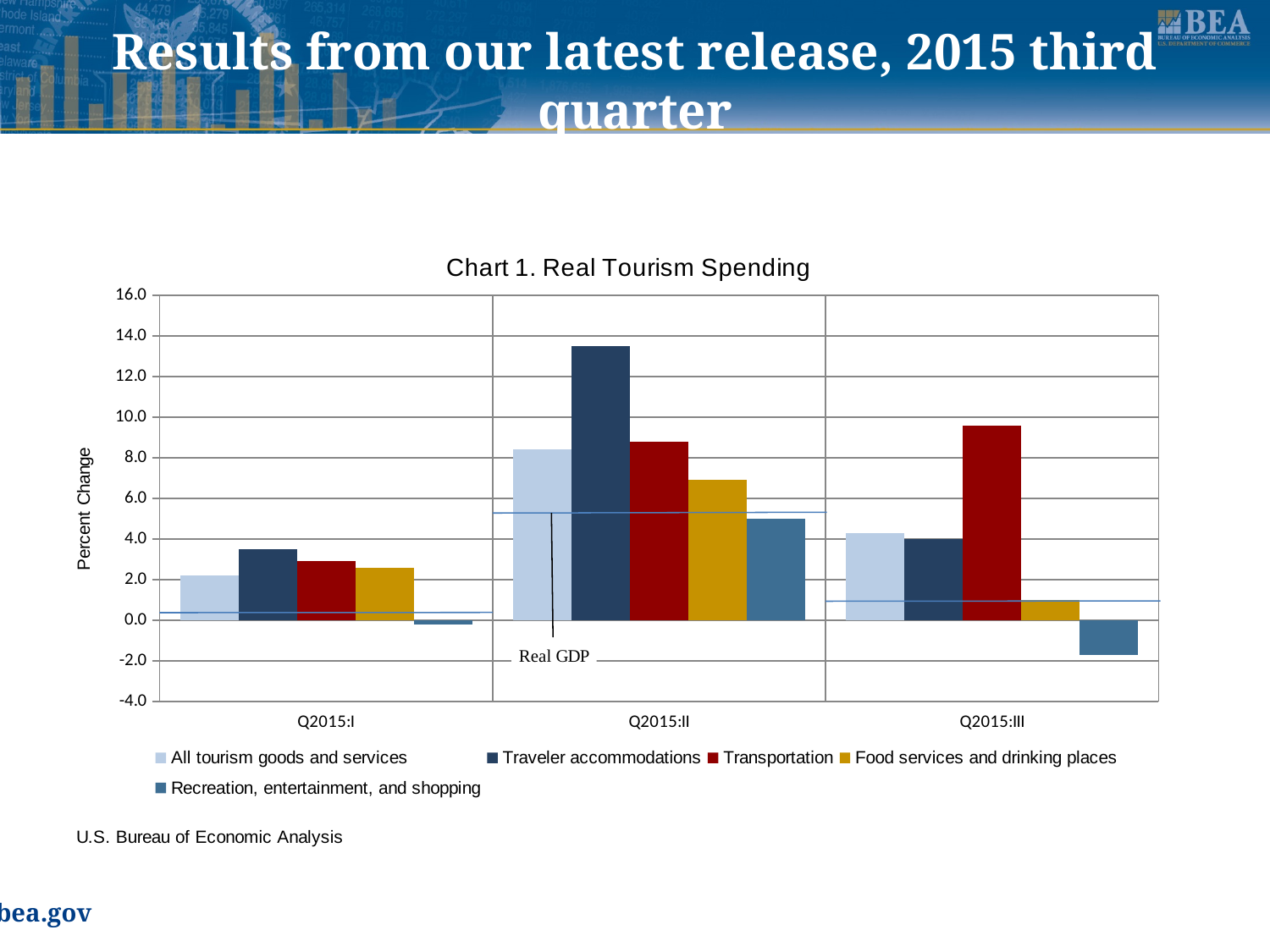
Is the value for Traveler accommodations in Q2015:II greater or less than 12.0? greater What kind of chart is Chart 1. Real Tourism Spending? bar chart In Q2015:II, which series has the highest percent change? Traveler accommodations In Q2015:II, which is larger: Transportation or Food services and drinking places? Transportation What is the label on the y axis of Chart 1? Percent Change In Q2015:III, which series has the highest percent change? Transportation How many series does the legend of Chart 1 list? 5 In Q2015:I, which series has the lowest percent change? Recreation, entertainment, and shopping Is the value for Transportation in Q2015:III greater or less than 8.0? greater In Q2015:III, which series has the lowest percent change? Recreation, entertainment, and shopping How many quarters are shown on the x axis of Chart 1? 3 Is the value for Recreation, entertainment, and shopping in Q2015:III greater or less than 0.0? less